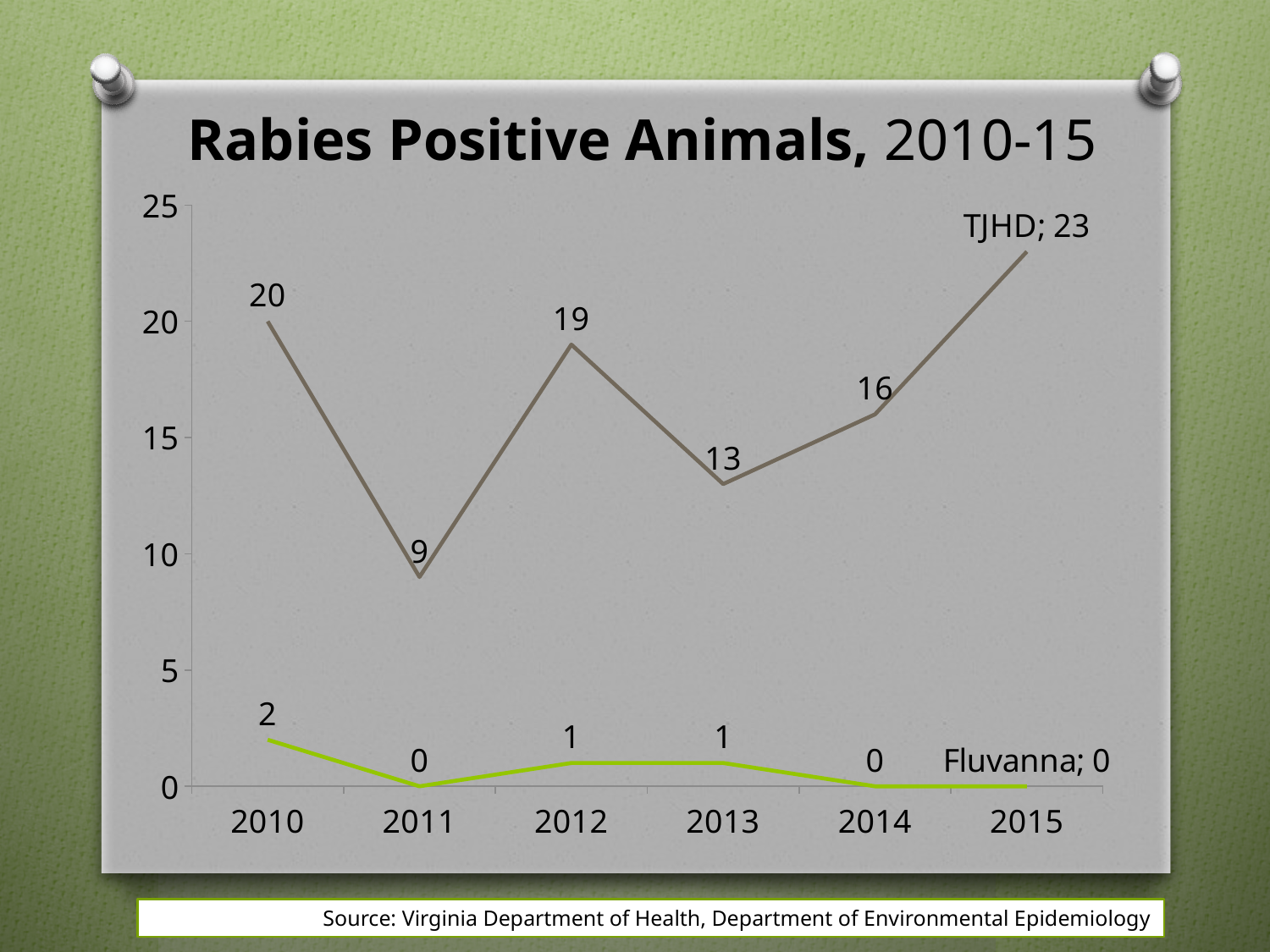
In which year is the TJHD value highest? 2015 What is the TJHD value for 2012? 19 Which is larger, the TJHD value for 2013 or for 2014? 2014 What is the TJHD value for 2015? 23 Does the TJHD line rise or fall from 2013 to 2015? Rise What type of chart is shown on the slide? Line chart In which year is the TJHD value lowest? 2011 How many series are plotted on the chart? 2 What is the Fluvanna value for 2010? 2 How many years are plotted on the x axis? 6 What is the title of the chart? Rabies Positive Animals, 2010-15 What is the difference between the TJHD values for 2010 and 2011? 11